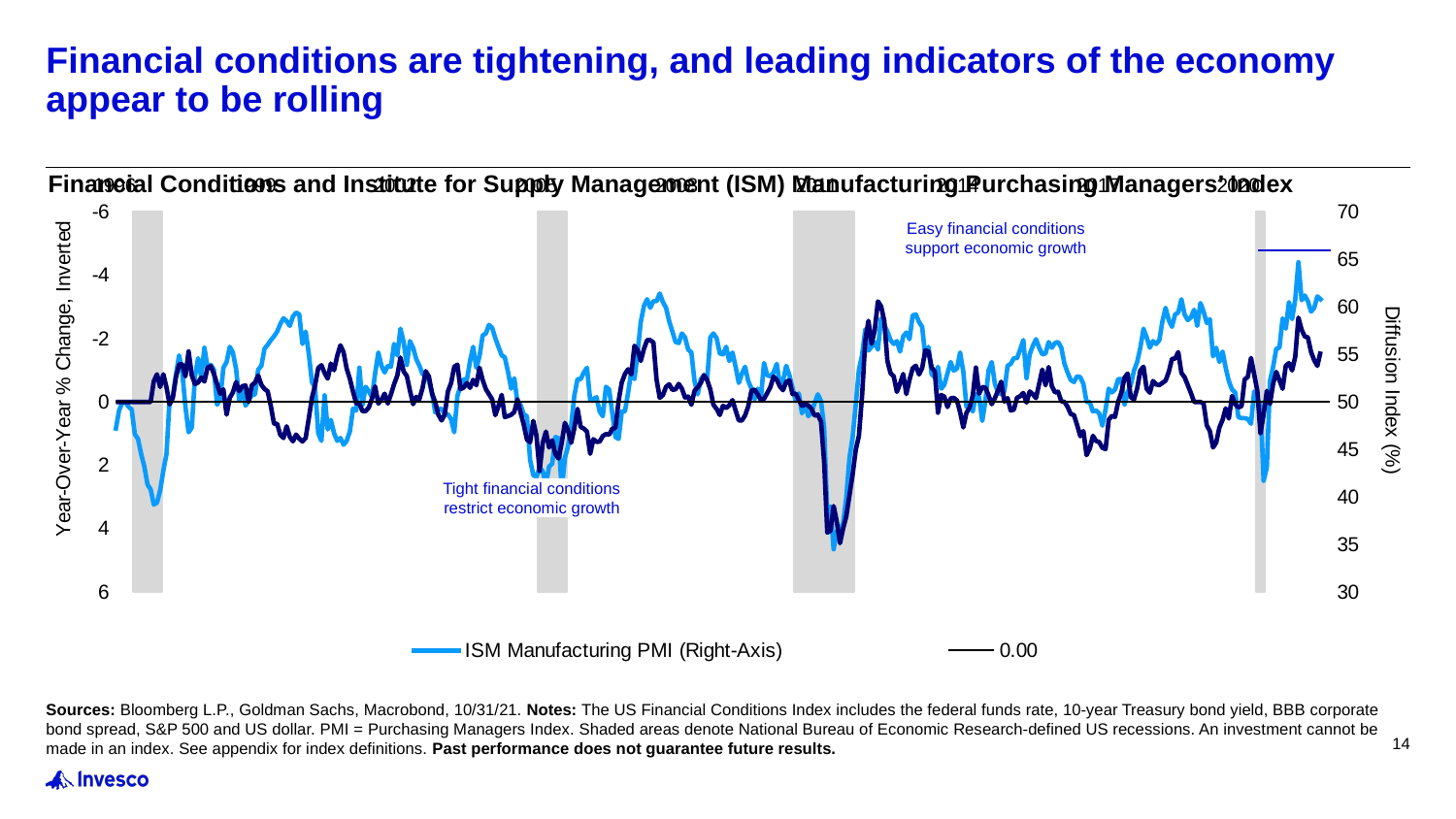
What is the lowest tick value shown on the right-hand axis? 30 Is the lowest value reached by the ISM Manufacturing PMI line (during the 2008-2009 recession) greater or less than 40 on the right axis? less How many shaded recession areas are shown on the chart? 4 Is the lowest value of the ISM Manufacturing PMI line during the 2020 recession greater or less than 45 on the right axis? less What kind of chart is shown on the slide? Line chart Which series does the legend say is plotted on the right axis? ISM Manufacturing PMI How many entries does the chart's legend list? 2 What is the label of the right-hand vertical axis? Diffusion Index (%) Is the highest value reached by the ISM Manufacturing PMI line (around 2021) greater or less than 60 on the right axis? greater What is the highest tick value shown on the right-hand axis? 70